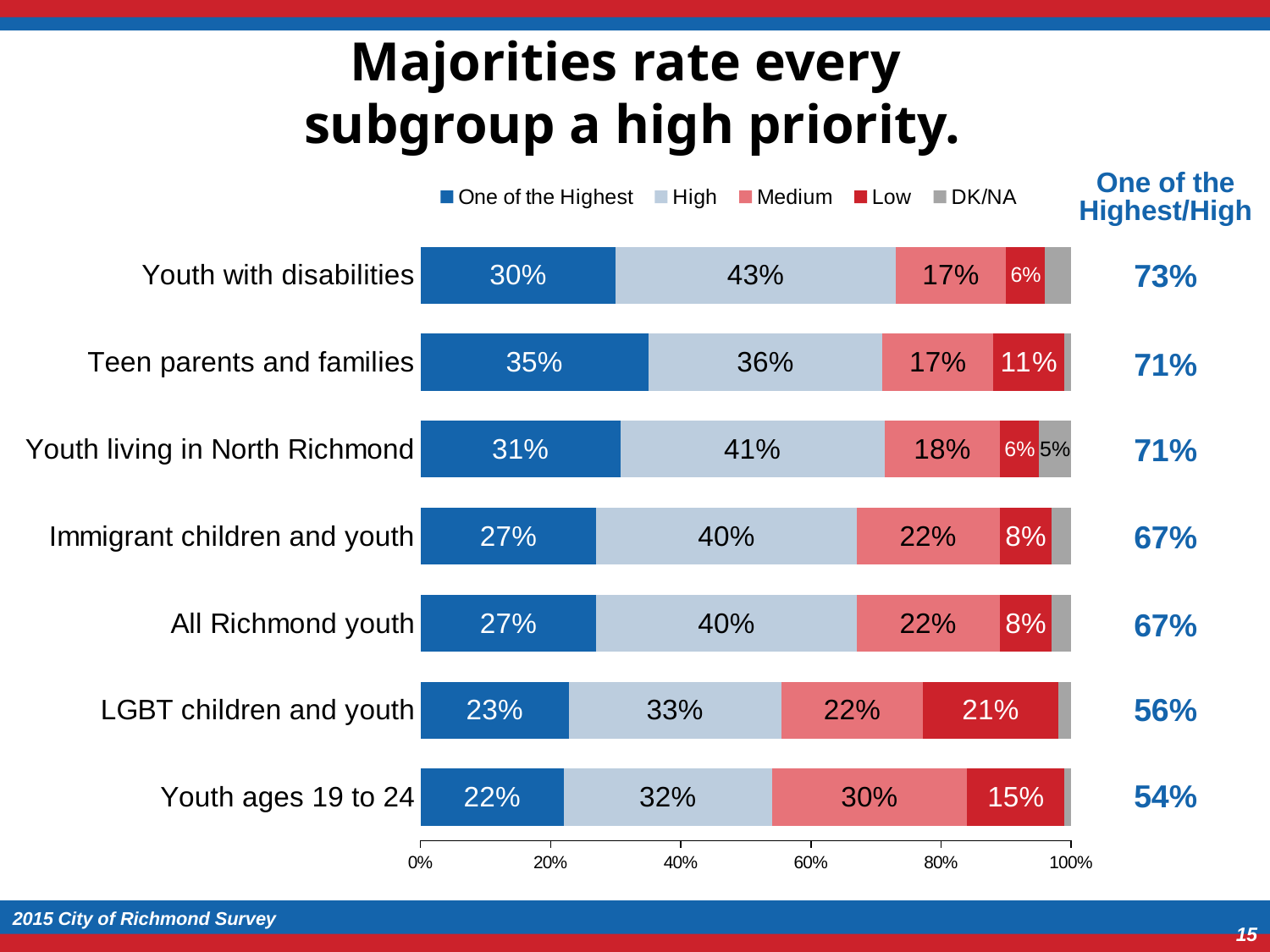
What type of chart is shown on the slide? Stacked bar chart Which subgroup has the lowest combined One of the Highest/High percentage? Youth ages 19 to 24 What is the Medium percentage for Youth ages 19 to 24? 30% What is the combined One of the Highest/High percentage shown for LGBT children and youth? 56% What percentage rated Youth with disabilities as One of the Highest priority? 30% What percentage rated Teen parents and families as a Low priority? 11% Which legend entry is shown in dark blue? One of the Highest What is the difference between the High percentage for Youth with disabilities and the High percentage for Youth ages 19 to 24? 11% How many series does the legend list? 5 How many subgroups are shown in the chart? 7 Which has a larger Low percentage: LGBT children and youth or Immigrant children and youth? LGBT children and youth Which subgroup has the highest One of the Highest percentage? Teen parents and families